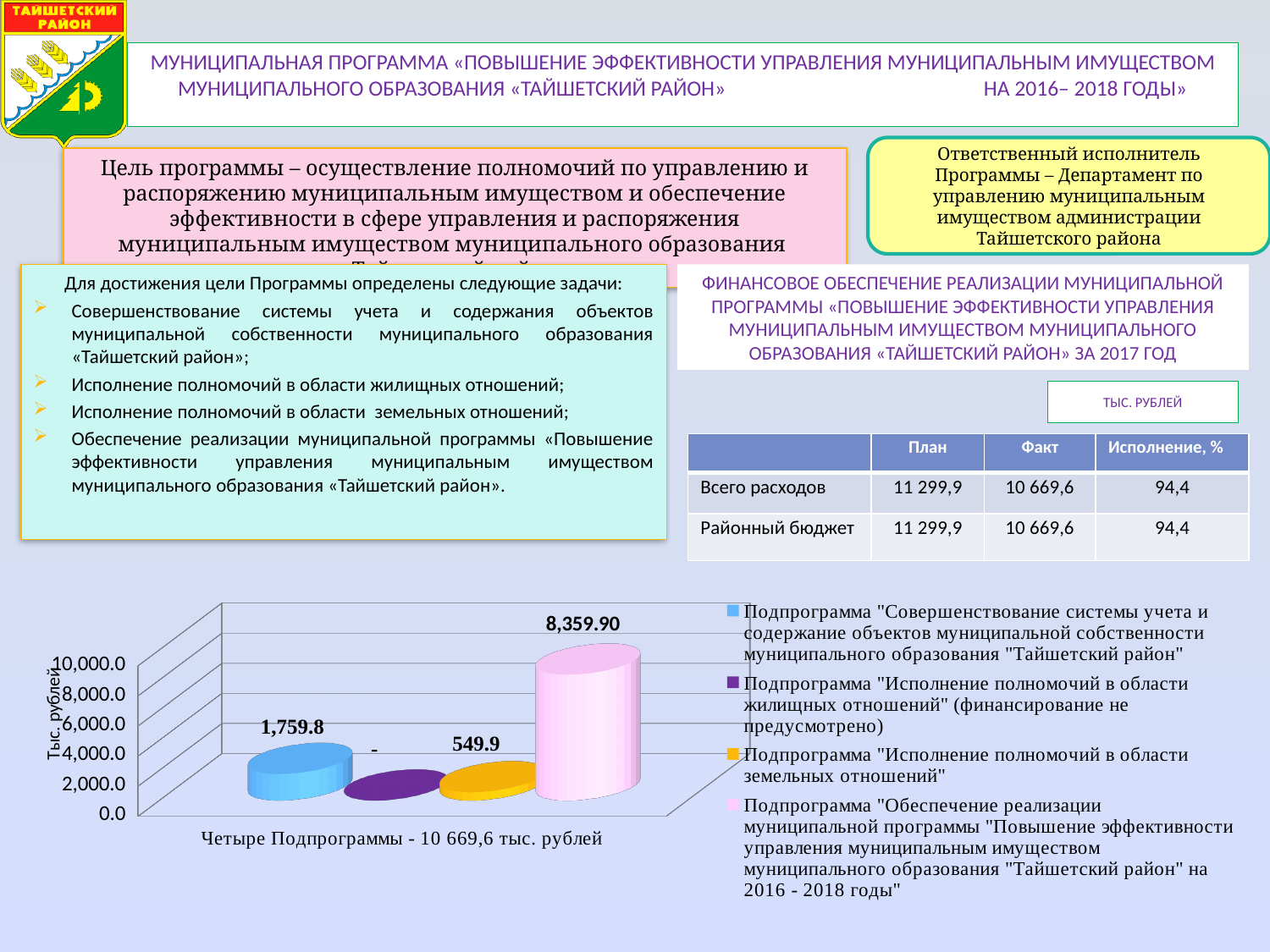
Which is larger: the value for the subprogram on accounting and maintenance of municipal property (1,759.8) or the value for the subprogram on land relations (549.9)? the subprogram on accounting and maintenance of municipal property (1,759.8) What type of chart is shown at the bottom of the slide? bar chart What total amount is stated in the caption below the chart for the four subprograms? 10 669,6 тыс. рублей What is the value shown for the subprogram "Исполнение полномочий в области земельных отношений"? 549.9 How many series does the legend of the chart list? 4 Which subprogram has the highest value in the chart? Подпрограмма "Обеспечение реализации муниципальной программы "Повышение эффективности управления муниципальным имуществом муниципального образования "Тайшетский район" на 2016 - 2018 годы" What is the value shown for the subprogram "Совершенствование системы учета и содержание объектов муниципальной собственности муниципального образования "Тайшетский район""? 1,759.8 What is the value shown for the subprogram "Обеспечение реализации муниципальной программы "Повышение эффективности управления муниципальным имуществом муниципального образования "Тайшетский район" на 2016 - 2018 годы""? 8,359.90 What is the difference between the value for the subprogram on ensuring implementation of the municipal program (8,359.90) and the value for the subprogram on land relations (549.9)? 7,810.0 What unit is shown on the vertical axis of the chart? Тыс. рублей Which subprogram has no funding shown in the chart (data label "-")? Подпрограмма "Исполнение полномочий в области жилищных отношений" Is the value for the subprogram on ensuring implementation of the municipal program greater or less than 8,000.0? greater